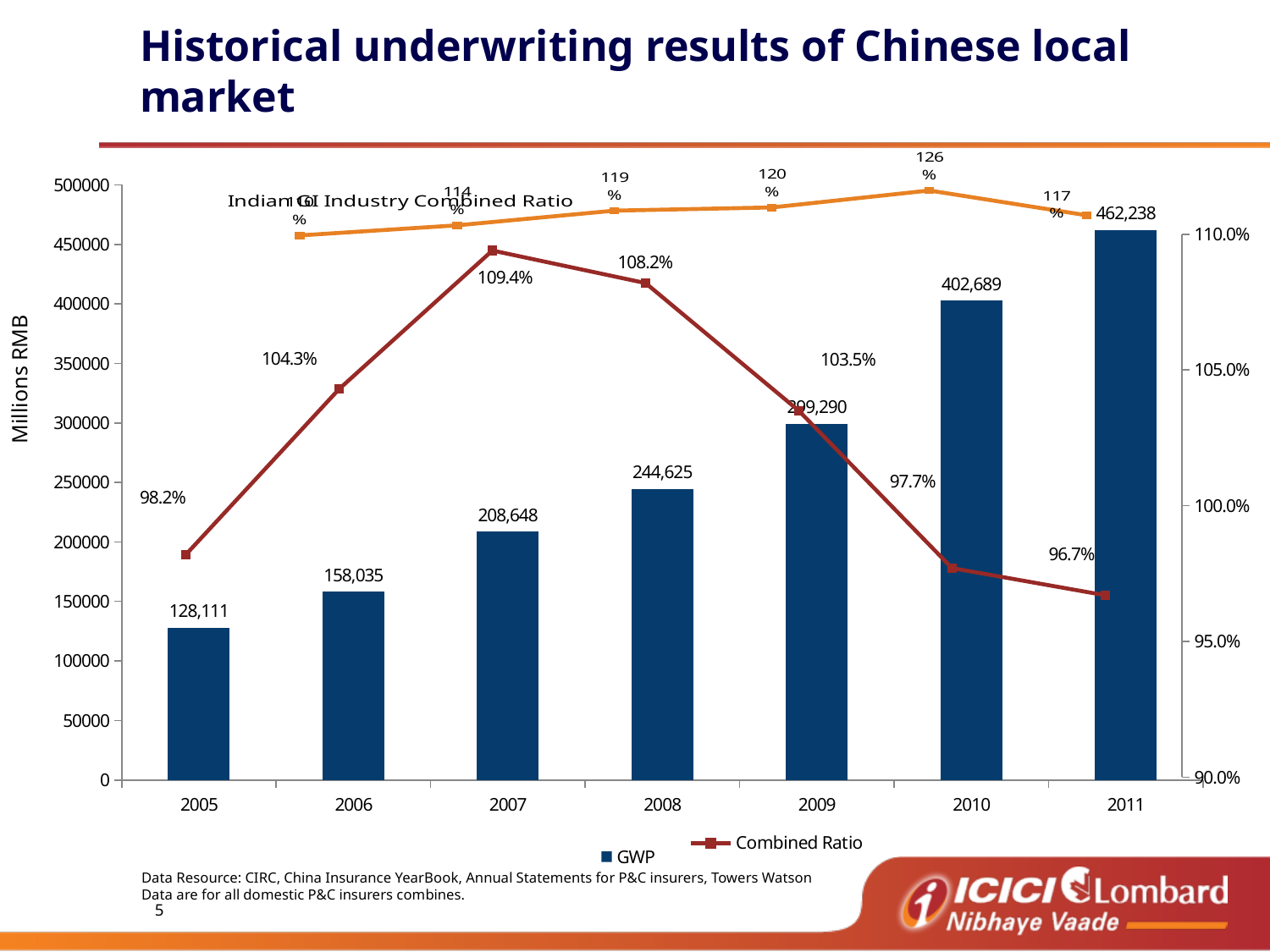
Which year has the highest GWP? 2011 Which year has the larger GWP, 2008 or 2009? 2009 What is the Combined Ratio for 2007? 109.4% How many series does the legend list? 2 What is the Combined Ratio for 2011? 96.7% What is the GWP value for 2011? 462,238 How many years are shown on the x axis? 7 Does GWP rise or fall from 2005 to 2011? Rises What is the difference in GWP between 2011 and 2010? 59,549 What is the GWP value for 2005? 128,111 Which year has the lowest Combined Ratio? 2011 Which year has the highest Combined Ratio? 2007